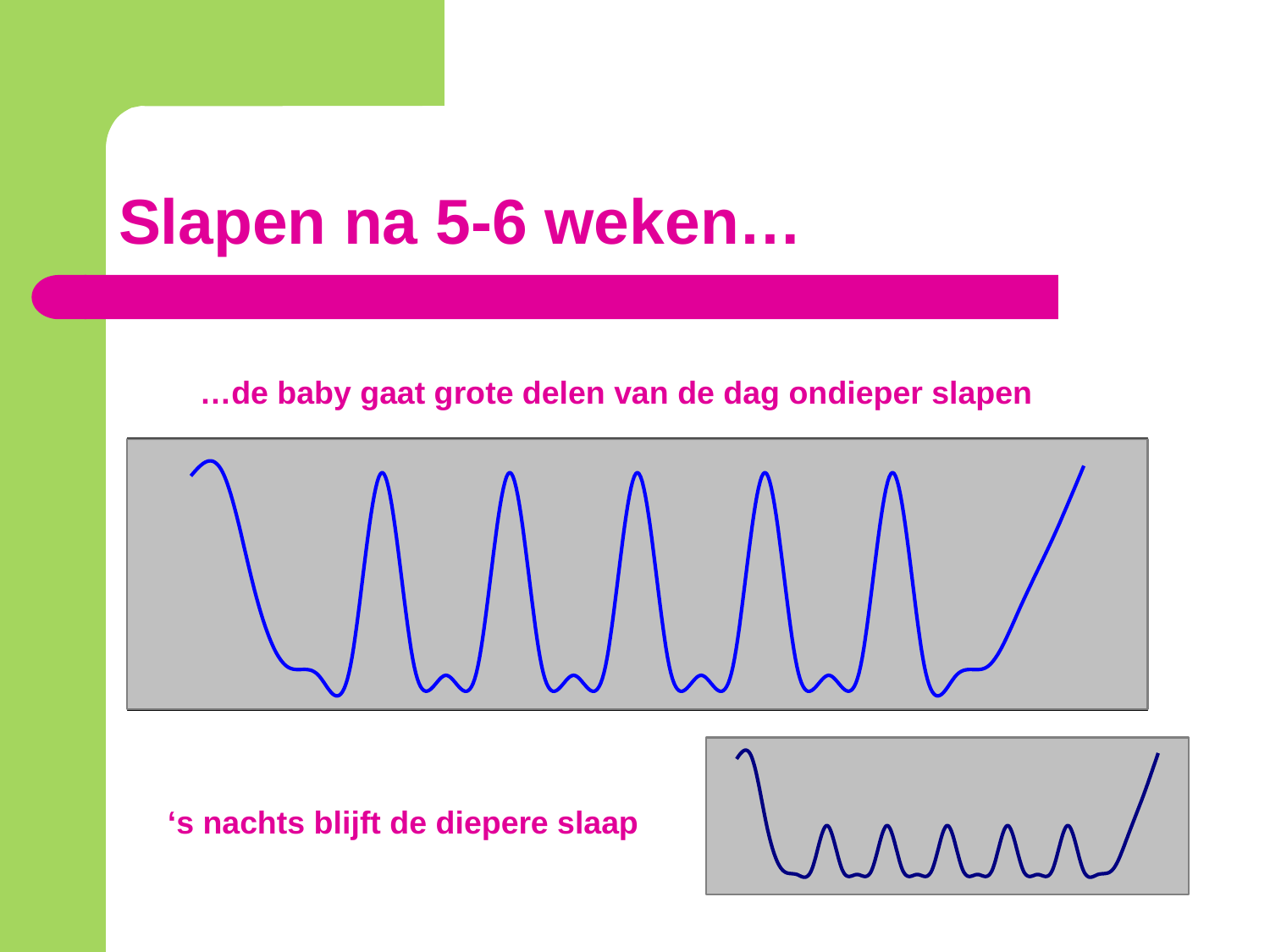
In the bottom chart, how many small peaks does the line have between its initial drop and its final rise? 5 How many charts are shown on the slide? 2 Are the peaks in the top chart taller or shorter than the peaks in the bottom chart, relative to the height of each chart box? taller What kind of chart is the top chart on the slide? line chart In the top chart, how many peaks does the line have between its starting point and its final rise? 5 What kind of chart is the bottom chart on the slide? line chart What colour is the line in the top chart? blue